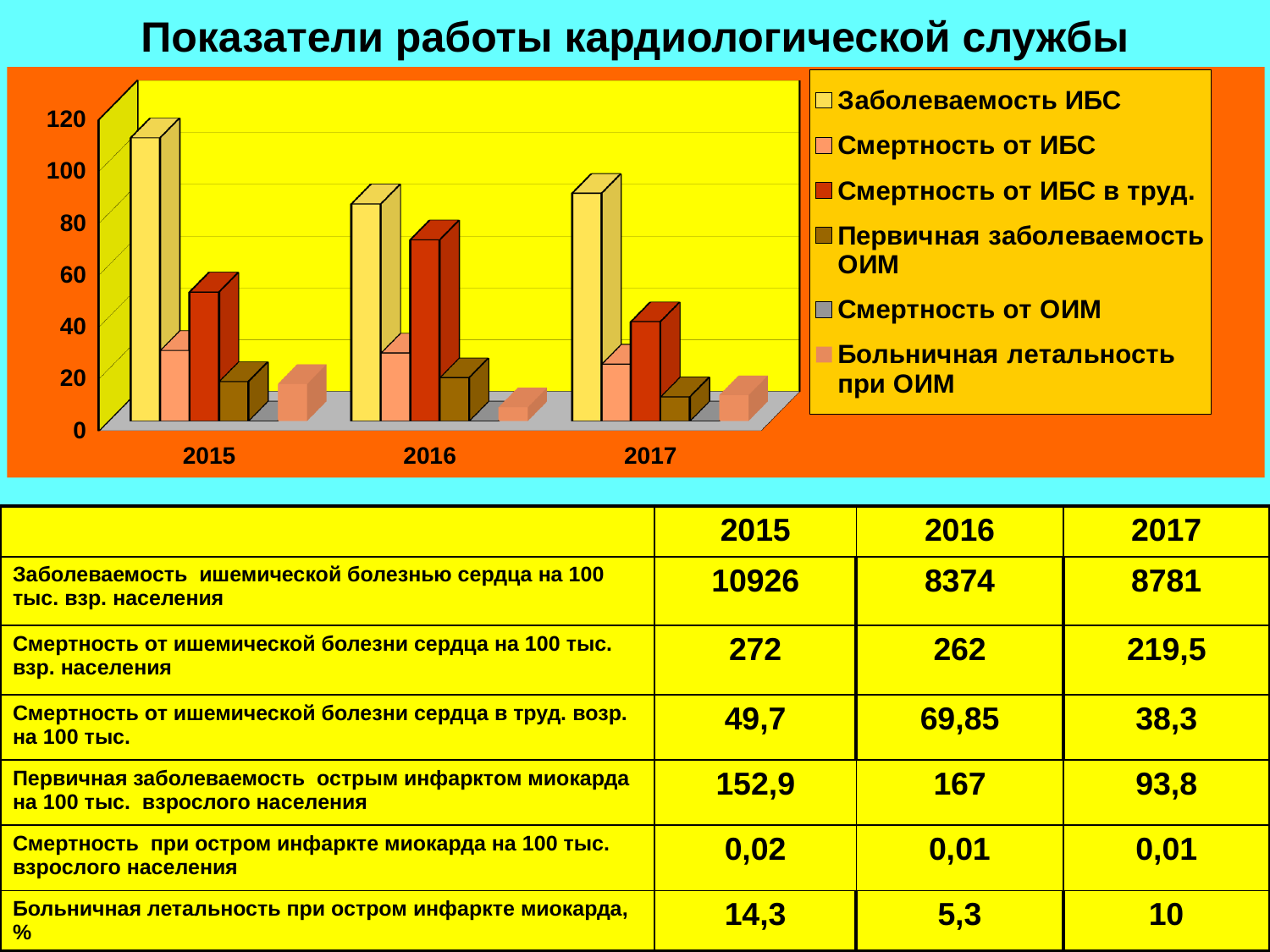
How many series does the chart legend list? 6 Is the value for Смертность от ИБС в труд. in 2016 greater or less than 60? greater Which is larger: Больничная летальность при ОИМ in 2015 or in 2016? 2015 Is the value for Заболеваемость ИБС in 2015 greater or less than 100? greater In which year is the bar for Заболеваемость ИБС the tallest? 2015 What is the title of the chart? Показатели работы кардиологической службы In which year is the bar for Смертность от ИБС в труд. the shortest? 2017 Which series is listed first in the chart legend? Заболеваемость ИБС Does the bar for Заболеваемость ИБС rise or fall from 2015 to 2016? fall What kind of chart is shown on the slide? bar chart In which year is the bar for Смертность от ИБС в труд. the tallest? 2016 How many years are shown on the x axis of the chart? 3